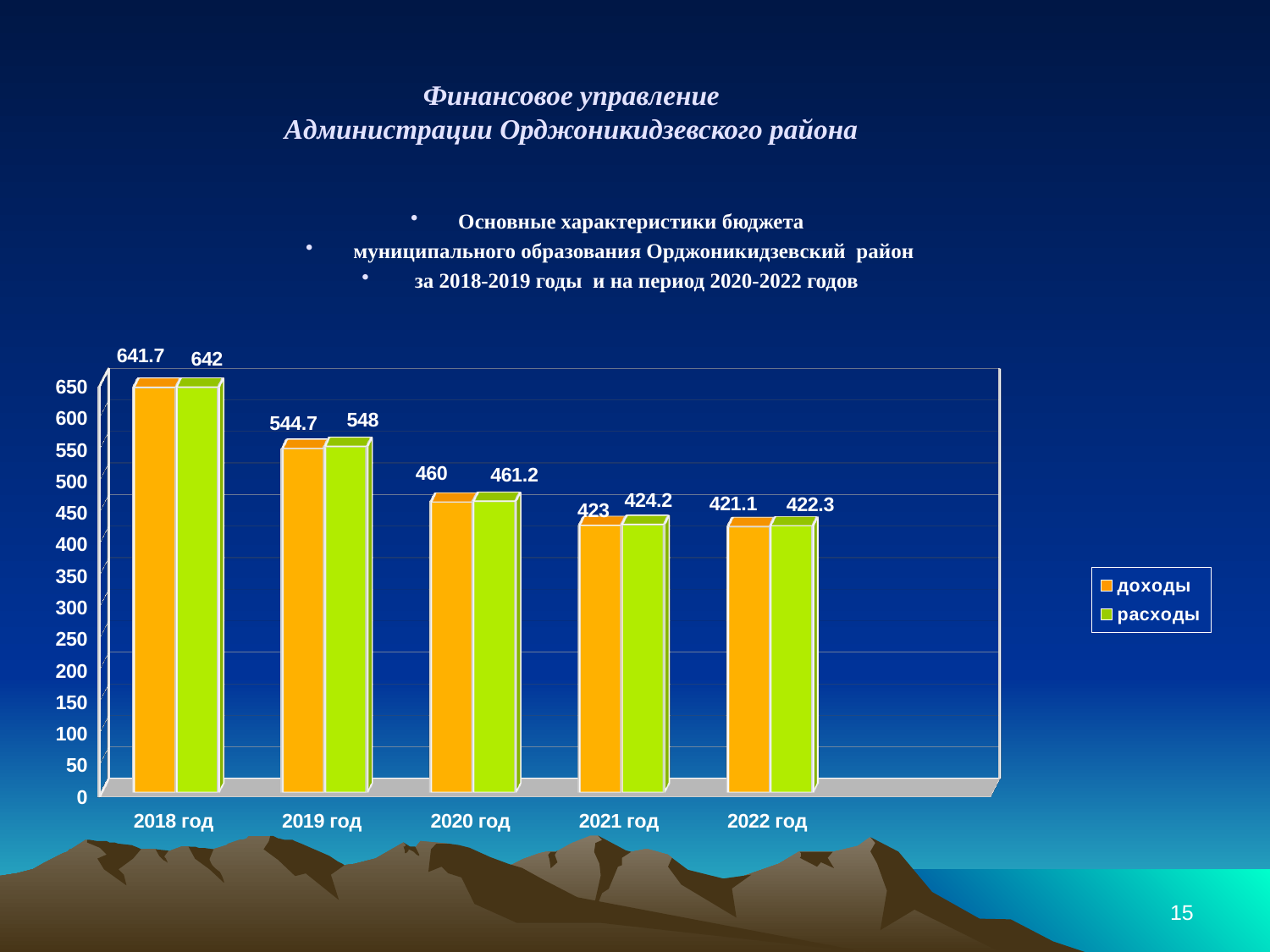
Which is larger: доходы for 2019 год or доходы for 2020 год? доходы for 2019 год What is the value of доходы for 2018 год? 641.7 What is the difference between доходы for 2018 год and доходы for 2019 год? 97 What kind of chart is shown on the slide? bar chart What is the difference between расходы and доходы for 2021 год? 1.2 How many years are shown on the x axis? 5 Which year has the highest value of расходы? 2018 год What is the value of расходы for 2020 год? 461.2 What is the value of доходы for 2022 год? 421.1 Do the доходы values rise or fall from 2018 год to 2022 год? fall Which year has the lowest value of доходы? 2022 год How many series does the legend list? 2